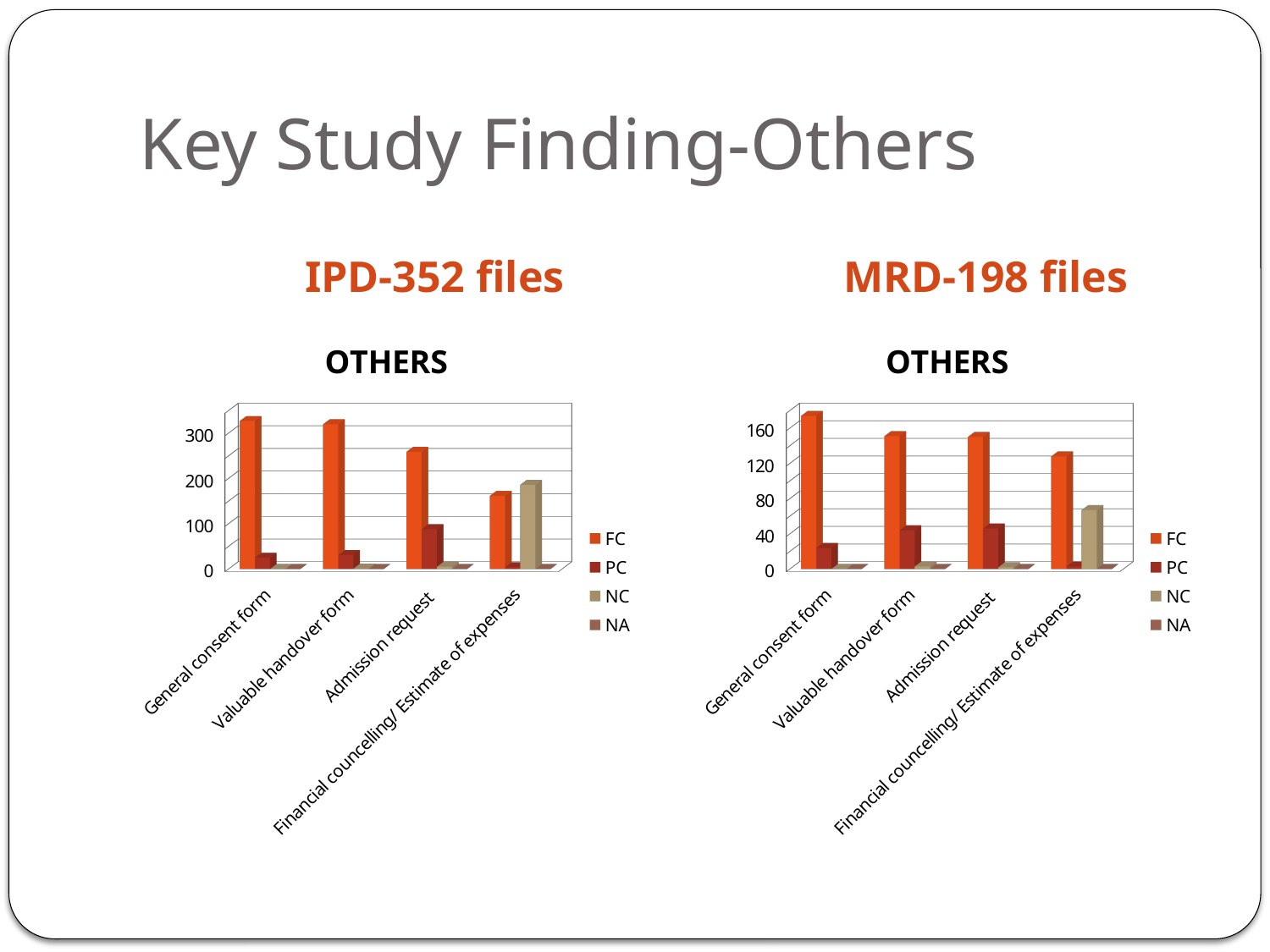
On the IPD-352 files chart, which category has the lowest FC value? Financial councelling/ Estimate of expenses On the MRD-198 files chart, which category has the highest NC value? Financial councelling/ Estimate of expenses On the MRD-198 files chart, is the FC value for General consent form greater or less than 160? greater On the MRD-198 files chart, which category has the lowest FC value? Financial councelling/ Estimate of expenses On the IPD-352 files chart, what kind of chart is shown? bar chart On the MRD-198 files chart, what are the legend entries? FC, PC, NC, NA On the IPD-352 files chart, is the FC value for Admission request greater or less than 200? greater On the IPD-352 files chart, do the FC values rise or fall from General consent form to Financial councelling/ Estimate of expenses? fall On the IPD-352 files chart, how many series does the legend list? 4 On the IPD-352 files chart, for Financial councelling/ Estimate of expenses, which is larger, FC or NC? NC On the IPD-352 files chart, is the NC value for Financial councelling/ Estimate of expenses greater or less than 100? greater On the IPD-352 files chart, how many categories are shown on the x axis? 4